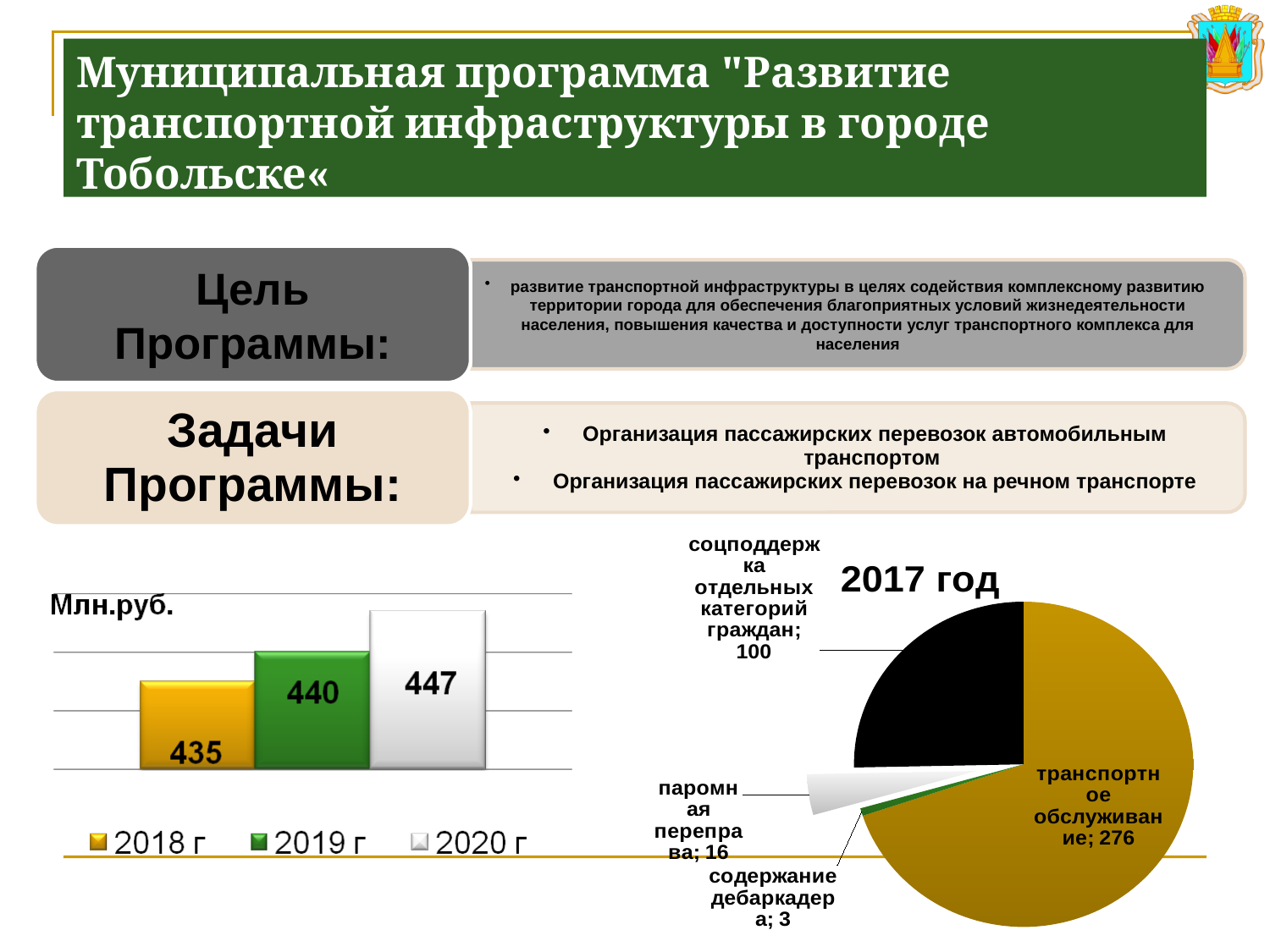
In the bar chart labelled Млн.руб., what is the value for 2019 г? 440 In the pie chart titled 2017 год, what is the value for содержание дебаркадера? 3 In the pie chart titled 2017 год, which category has the largest slice? транспортное обслуживание In the pie chart titled 2017 год, what is the value for транспортное обслуживание? 276 In the bar chart labelled Млн.руб., how many series does the legend list? 3 In the bar chart labelled Млн.руб., what is the value for 2020 г? 447 In the pie chart titled 2017 год, how many slices are there? 4 In the bar chart labelled Млн.руб., which year has the highest value? 2020 г In the bar chart labelled Млн.руб., which year has the lowest value? 2018 г What kind of chart is the chart titled 2017 год? pie chart In the bar chart labelled Млн.руб., what is the difference between the values for 2020 г and 2018 г? 12 In the bar chart labelled Млн.руб., do the values rise or fall from 2018 г to 2020 г? rise